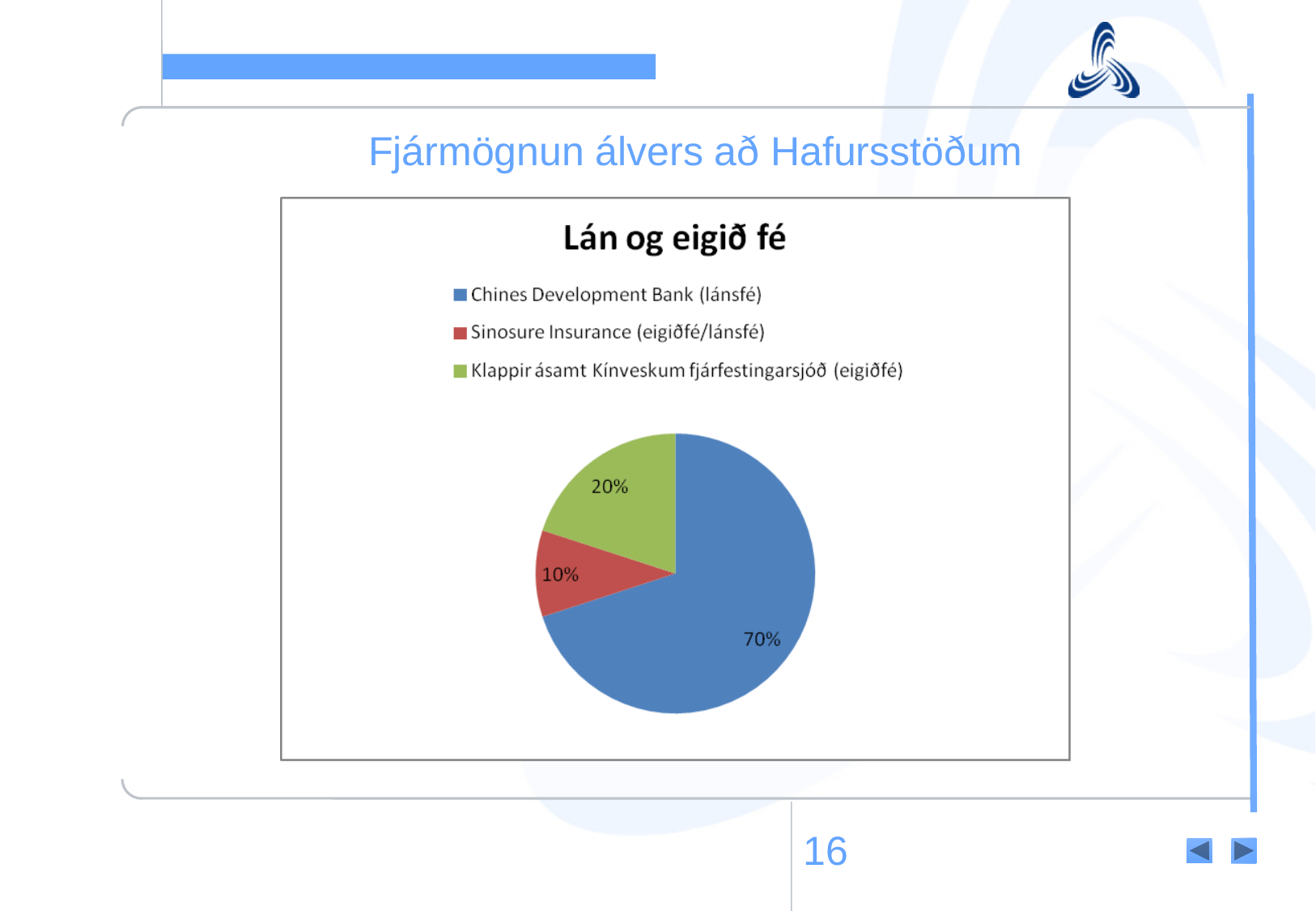
Which category has the largest slice of the pie? Chines Development Bank (lánsfé) What share of the pie does Chines Development Bank (lánsfé) hold? 70% How many slices does the pie chart have? 3 Which is larger, the Sinosure Insurance slice or the Klappir ásamt Kínveskum fjárfestingarsjóð slice? Klappir ásamt Kínveskum fjárfestingarsjóð (eigiðfé) How many entries does the legend list? 3 What kind of chart is shown on the slide? pie chart What is the difference in percentage points between the Chines Development Bank slice and the Klappir ásamt Kínveskum fjárfestingarsjóð slice? 50 percentage points Which category has the smallest slice of the pie? Sinosure Insurance (eigiðfé/lánsfé) What colour is the slice for Sinosure Insurance (eigiðfé/lánsfé)? red What share of the pie does Sinosure Insurance (eigiðfé/lánsfé) hold? 10% What is the title of the chart? Lán og eigið fé What share of the pie does Klappir ásamt Kínveskum fjárfestingarsjóð (eigiðfé) hold? 20%